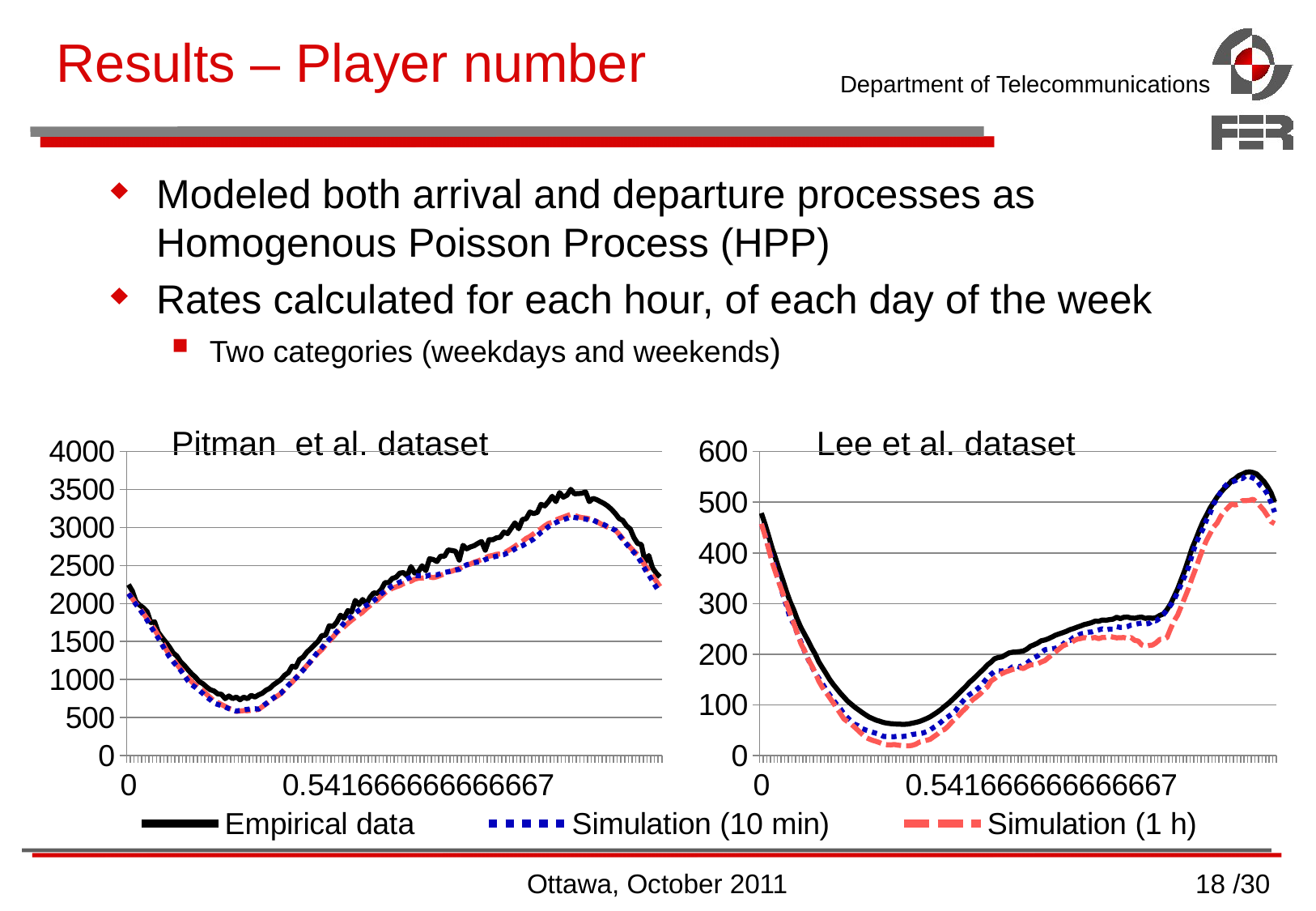
In the Pitman et al. dataset chart, is the lowest value of the Empirical data greater or less than 1000? less What kind of chart is the Pitman et al. dataset chart? line chart In the Pitman et al. dataset chart, which series reaches a higher peak, Empirical data or Simulation (10 min)? Empirical data In the Lee et al. dataset chart, is the lowest value of the Empirical data greater or less than 100? less In the Pitman et al. dataset chart, is the peak value of the Empirical data greater or less than 3000? greater What are the three series named in the legend? Empirical data, Simulation (10 min), Simulation (1 h) How many series does the legend list for the charts? 3 In the Lee et al. dataset chart, which series is lower at the right end of the x axis, Empirical data or Simulation (1 h)? Simulation (1 h) In the Pitman et al. dataset chart, do the Empirical data values rise or fall over the first part of the x axis? fall What is the title of the chart on the right side of the slide? Lee et al. dataset